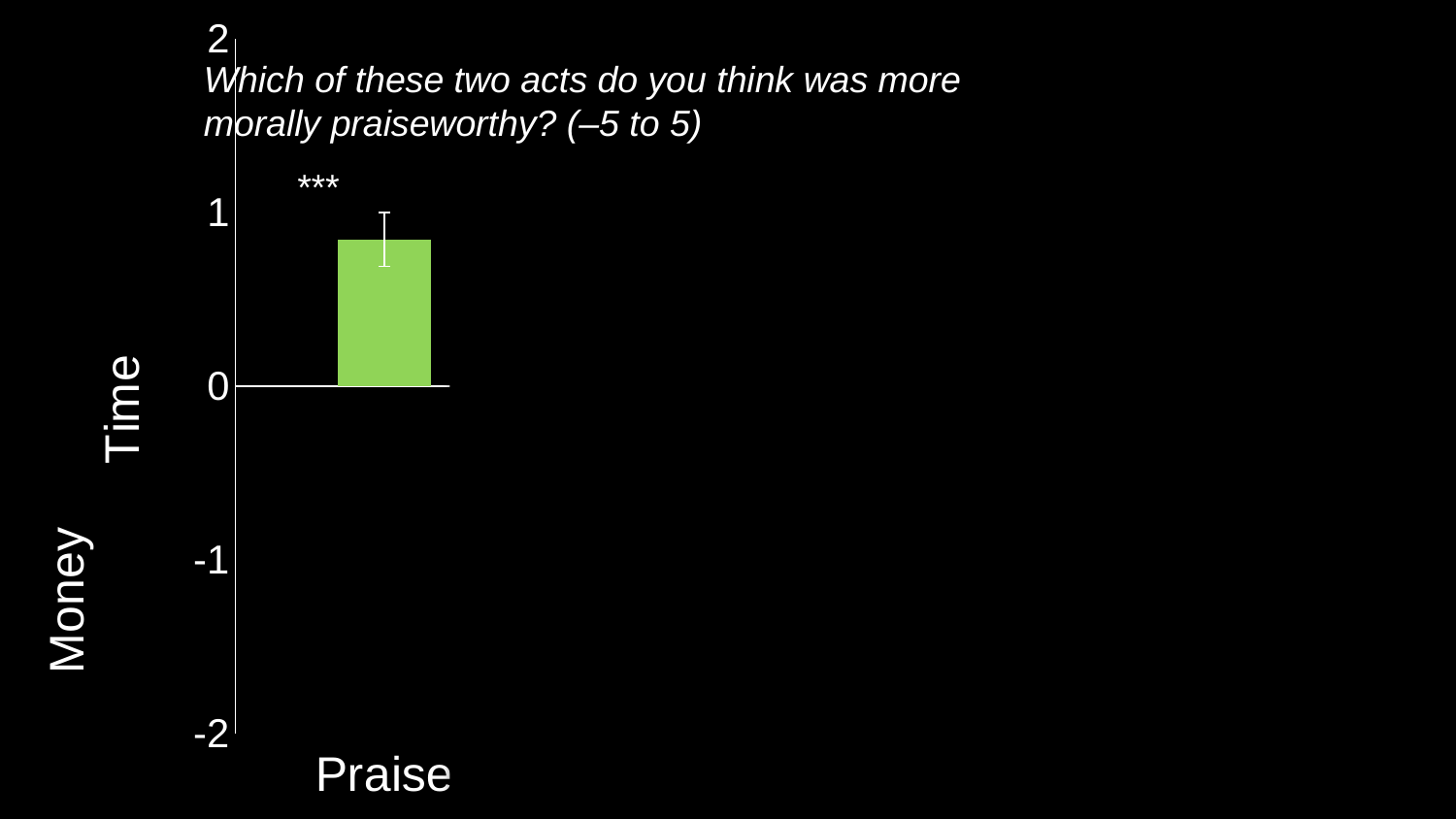
What is the category label under the bar? Praise What is the lowest tick value shown on the vertical axis? -2 How many bars are plotted in the chart? 1 What kind of chart is shown on the slide? bar chart Is the value for Praise greater or less than 0? greater What colour is the Praise bar? green Is the value for Praise greater or less than 2? less Is the value for Praise greater or less than 1? less